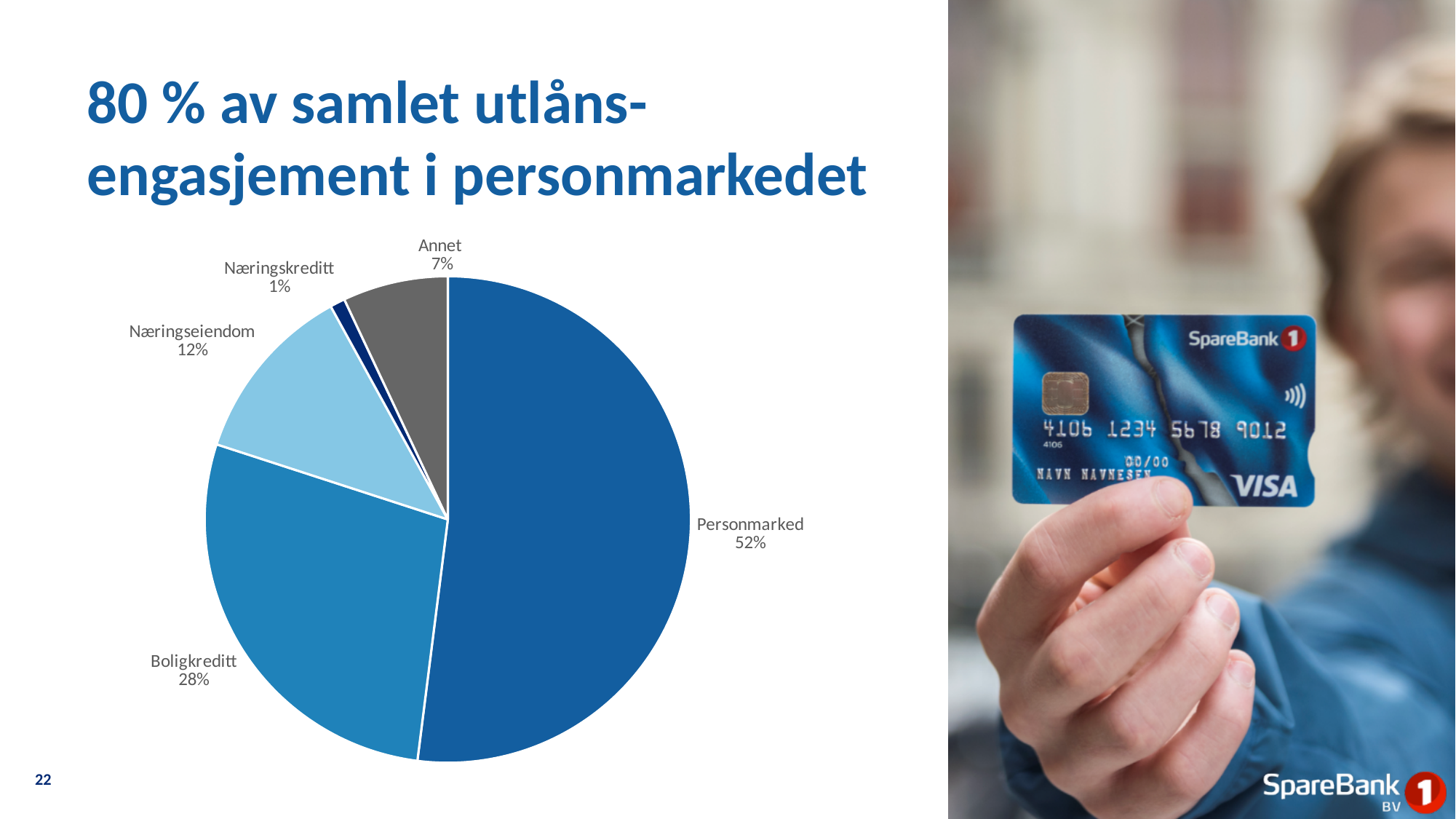
What is the value shown for Boligkreditt? 28% Which category has the largest slice of the pie? Personmarked What is the value shown for Annet? 7% What kind of chart is shown on the slide? Pie chart What is the value shown for Næringseiendom? 12% How many categories are shown in the pie chart? 5 Which category has the smallest slice of the pie? Næringskreditt What is the combined share of Personmarked and Boligkreditt? 80% Which is larger, Næringseiendom or Annet? Næringseiendom What is the difference between the Personmarked and Boligkreditt shares? 24% What share of the pie does Personmarked represent? 52% What colour is the Annet slice? Grey